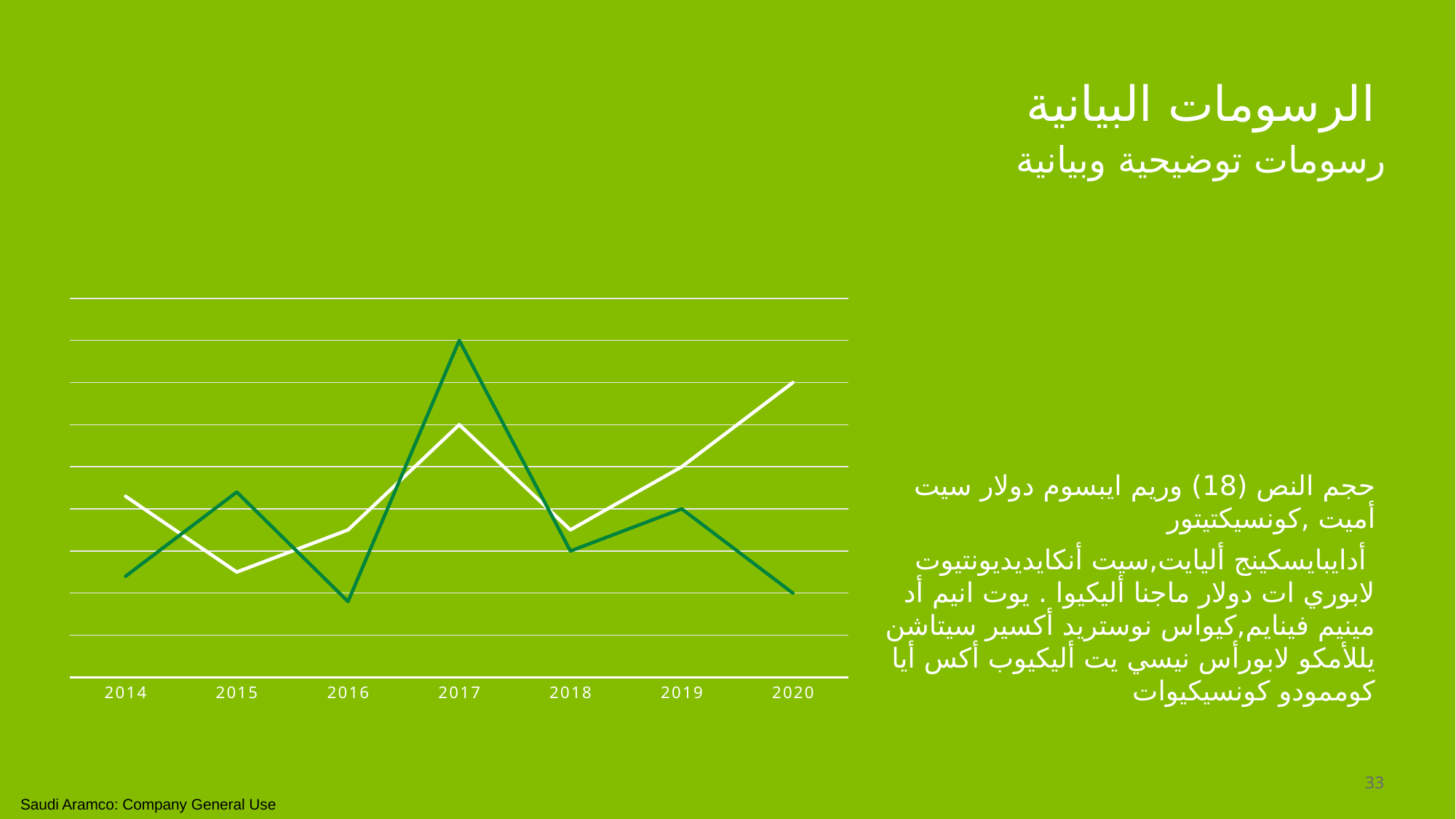
Does the dark green line rise or fall from 2019 to 2020? fall In which year does the white line reach its highest point? 2020 In 2015, which line is higher, the white line or the dark green line? dark green line In 2017, which line is higher, the white line or the dark green line? dark green line What kind of chart is shown on the slide? line chart In which year does the dark green line reach its highest point? 2017 In 2020, which line is higher, the white line or the dark green line? white line How many years are shown on the x axis of the chart? 7 In which year does the white line reach its lowest point? 2015 Does the white line rise or fall from 2018 to 2020? rise How many lines are plotted on the chart? 2